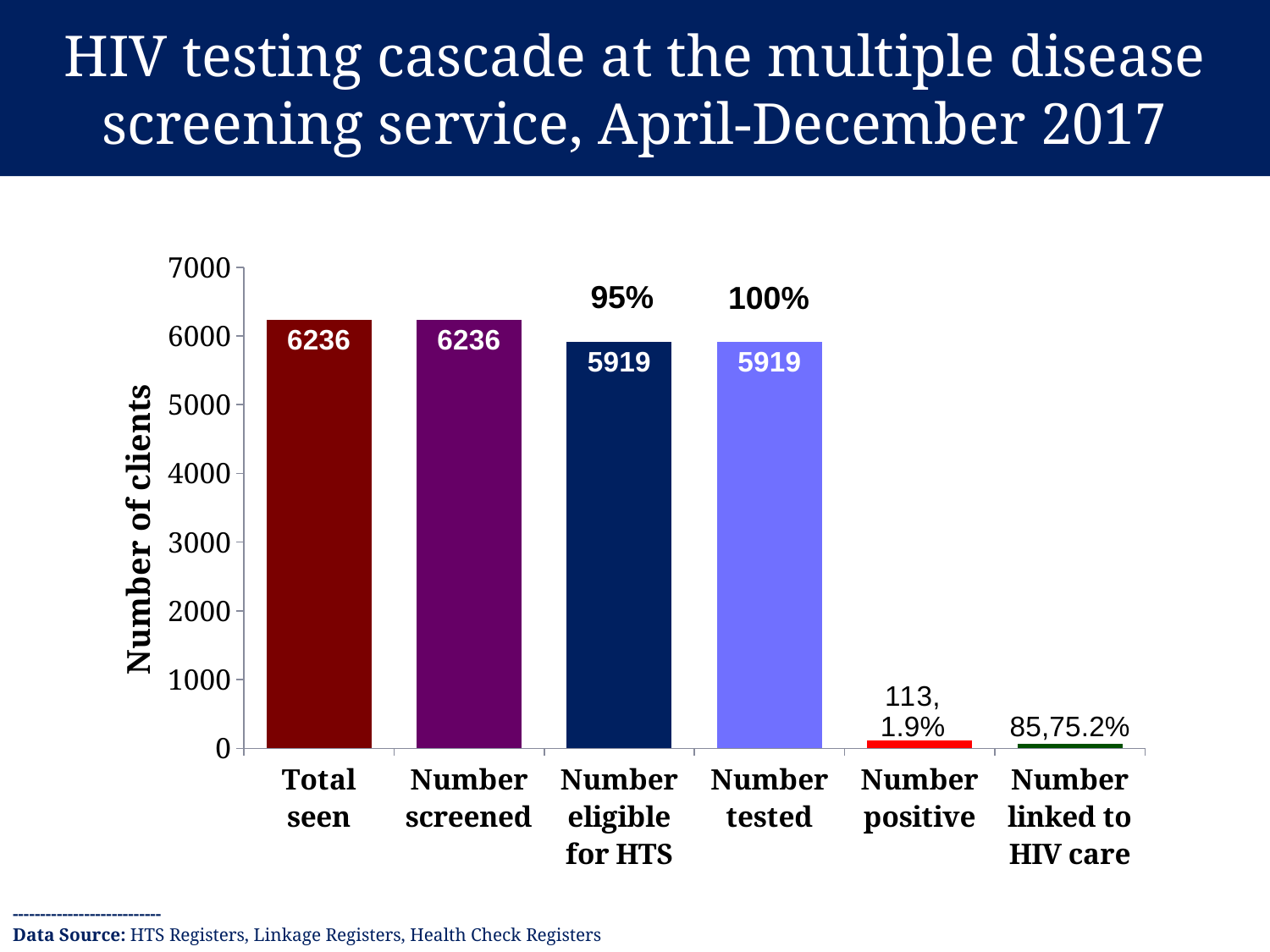
What is the difference between Number positive and Number linked to HIV care? 28 What percentage is shown next to the Number linked to HIV care value? 75.2% What is the value for Number linked to HIV care? 85 Which category has the lowest value? Number linked to HIV care What percentage is shown above the Number eligible for HTS bar? 95% Which is larger, Number tested or Number positive? Number tested What is the value for Total seen? 6236 How many categories are shown on the x axis? 6 What kind of chart is shown on the slide? Bar chart What is the value for Number eligible for HTS? 5919 What is the value for Number positive? 113 What is the difference between Number screened and Number eligible for HTS? 317